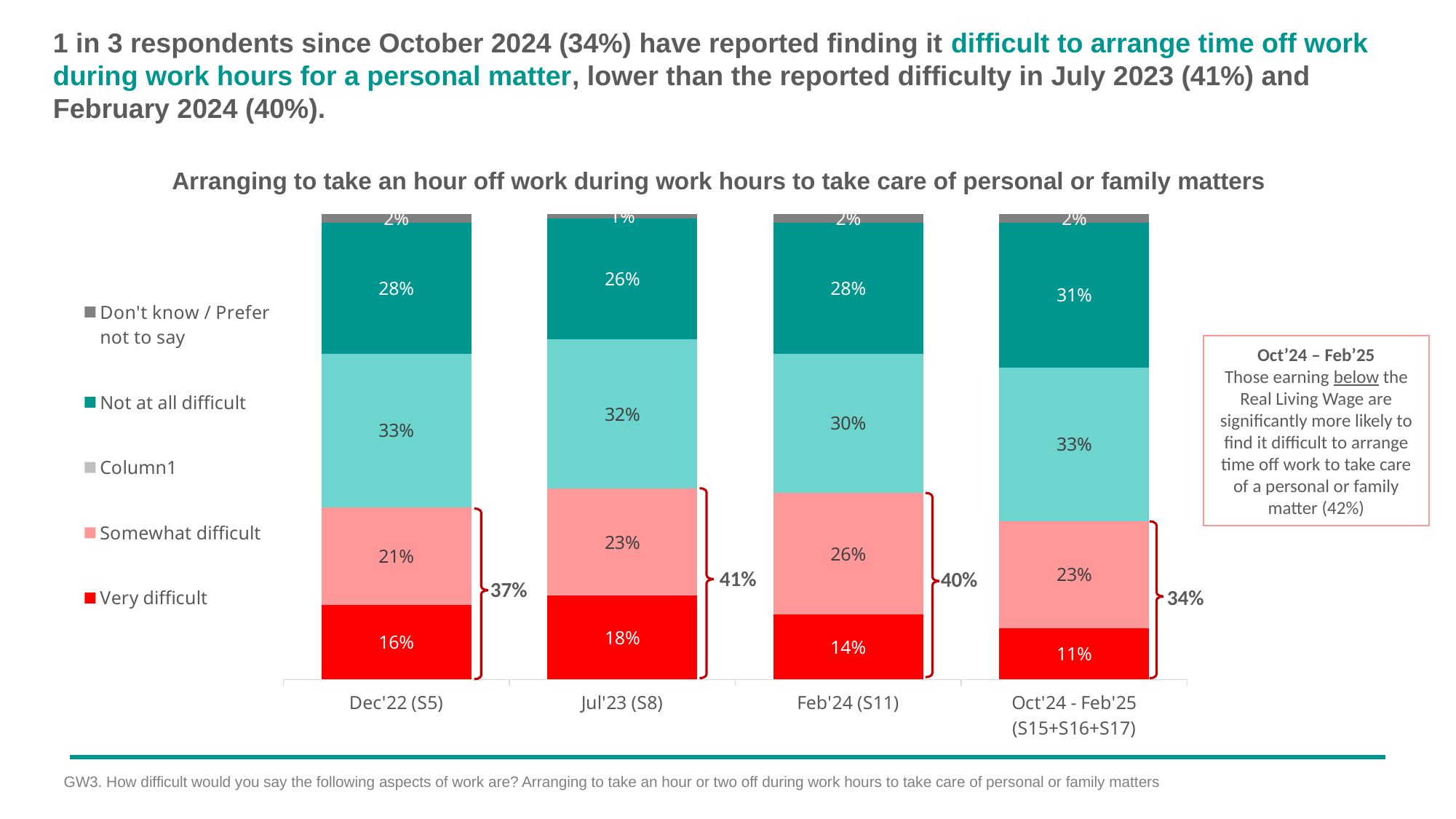
Which period has the highest 'Very difficult' percentage? Jul'23 (S8) How many survey periods are shown on the x axis? 4 What is the 'Don't know / Prefer not to say' value for Jul'23 (S8)? 1% What percentage of respondents said 'Very difficult' in Dec'22 (S5)? 16% What is the 'Not at all difficult' value for Oct'24 - Feb'25 (S15+S16+S17)? 31% What combined 'difficult' percentage is shown by the bracket for Jul'23 (S8)? 41% Which period has the lowest 'Very difficult' percentage? Oct'24 - Feb'25 (S15+S16+S17) From Jul'23 (S8) onward, does the 'Very difficult' percentage rise or fall across the periods? Fall How many series does the legend list? 5 Which has the larger 'Not at all difficult' value, Jul'23 (S8) or Feb'24 (S11)? Feb'24 (S11) What type of chart is shown on the slide? Stacked bar chart How many percentage points higher is 'Somewhat difficult' in Feb'24 (S11) than in Dec'22 (S5)? 5 percentage points